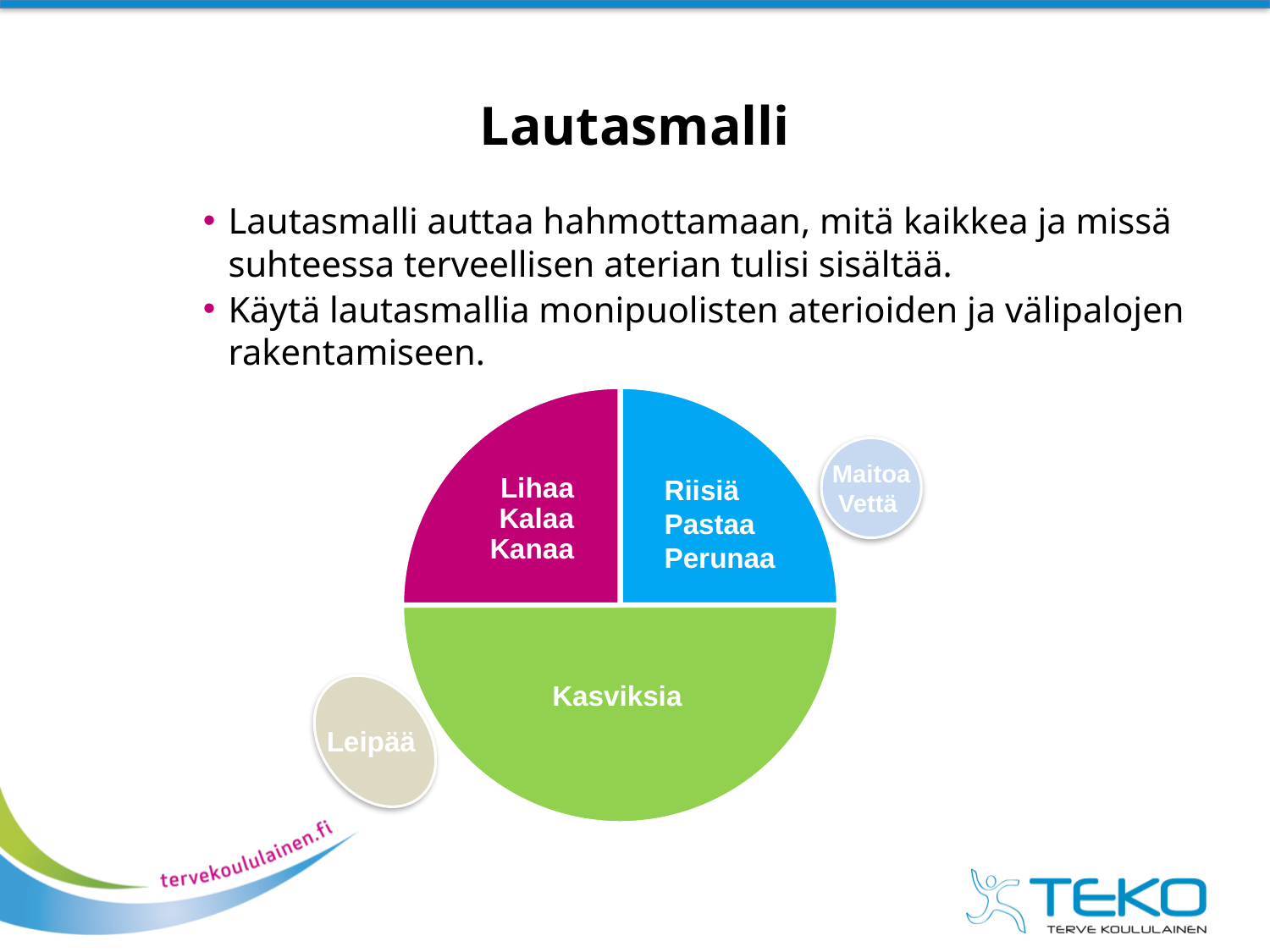
What colour is the Kasviksia slice of the pie chart? green How many slices does the pie chart have? 3 What kind of chart is shown on the slide? pie chart Which slice of the pie chart is the largest? Kasviksia Which slice is larger, Kasviksia or Riisiä Pastaa Perunaa? Kasviksia Which slice is larger, Kasviksia or Lihaa Kalaa Kanaa? Kasviksia What is the title of the slide containing the pie chart? Lautasmalli